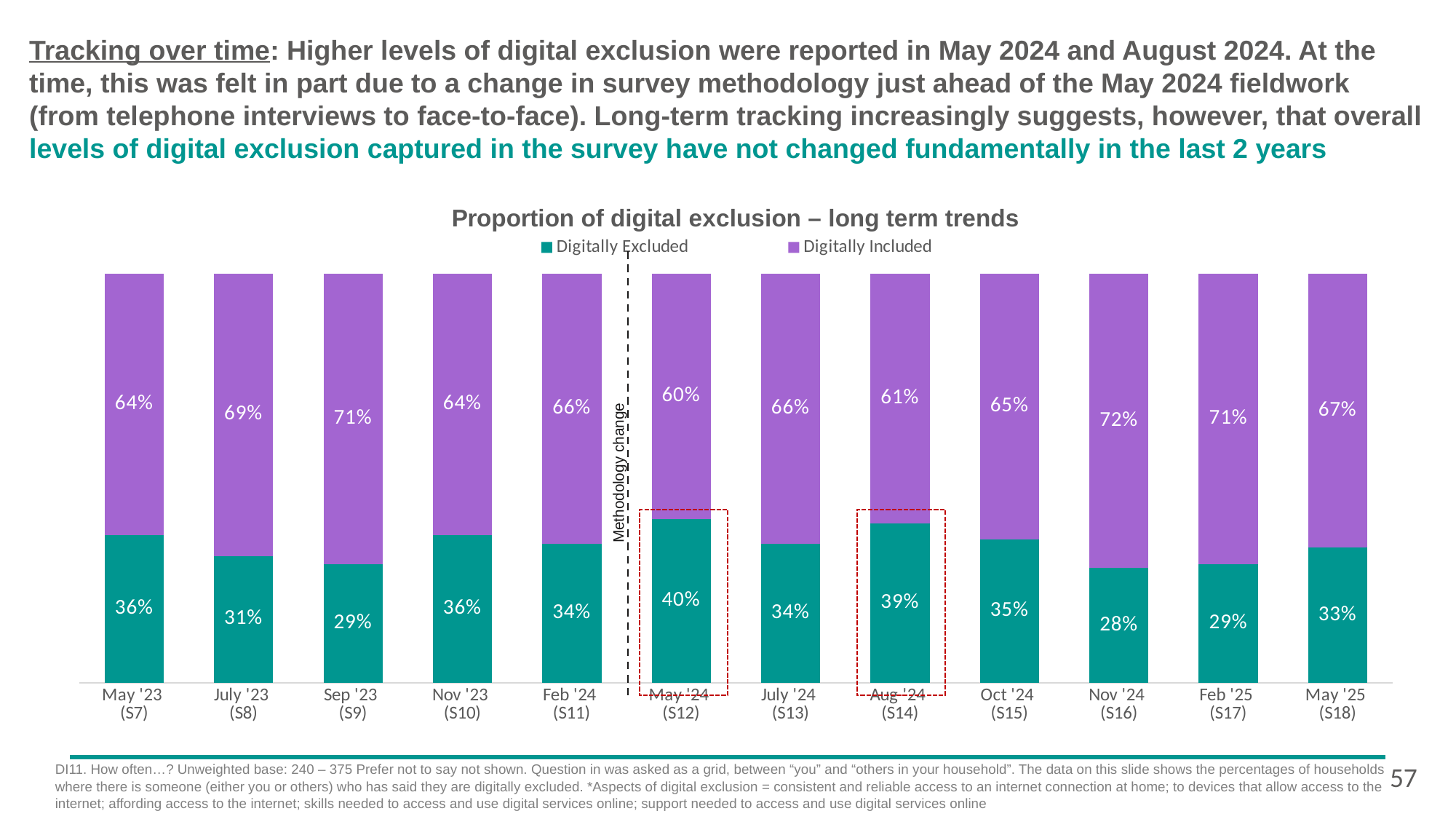
What percentage were Digitally Excluded in May '24 (S12)? 40% What kind of chart is shown on the slide? Stacked bar chart How many series does the legend list? 2 What is the difference between the Digitally Excluded percentage in May '24 (S12) and Nov '24 (S16)? 12% How many survey waves are shown on the x axis? 12 What is the title of the chart? Proportion of digital exclusion – long term trends What percentage were Digitally Included in Nov '24 (S16)? 72% Which survey wave has the lowest Digitally Excluded percentage? Nov '24 (S16) Which is larger: the Digitally Excluded percentage in Aug '24 (S14) or in Oct '24 (S15)? Aug '24 (S14) Which survey wave has the highest Digitally Excluded percentage? May '24 (S12) What is the total of the stacked bar for Sep '23 (S9)? 100% What does the dashed vertical line between Feb '24 and May '24 indicate? Methodology change